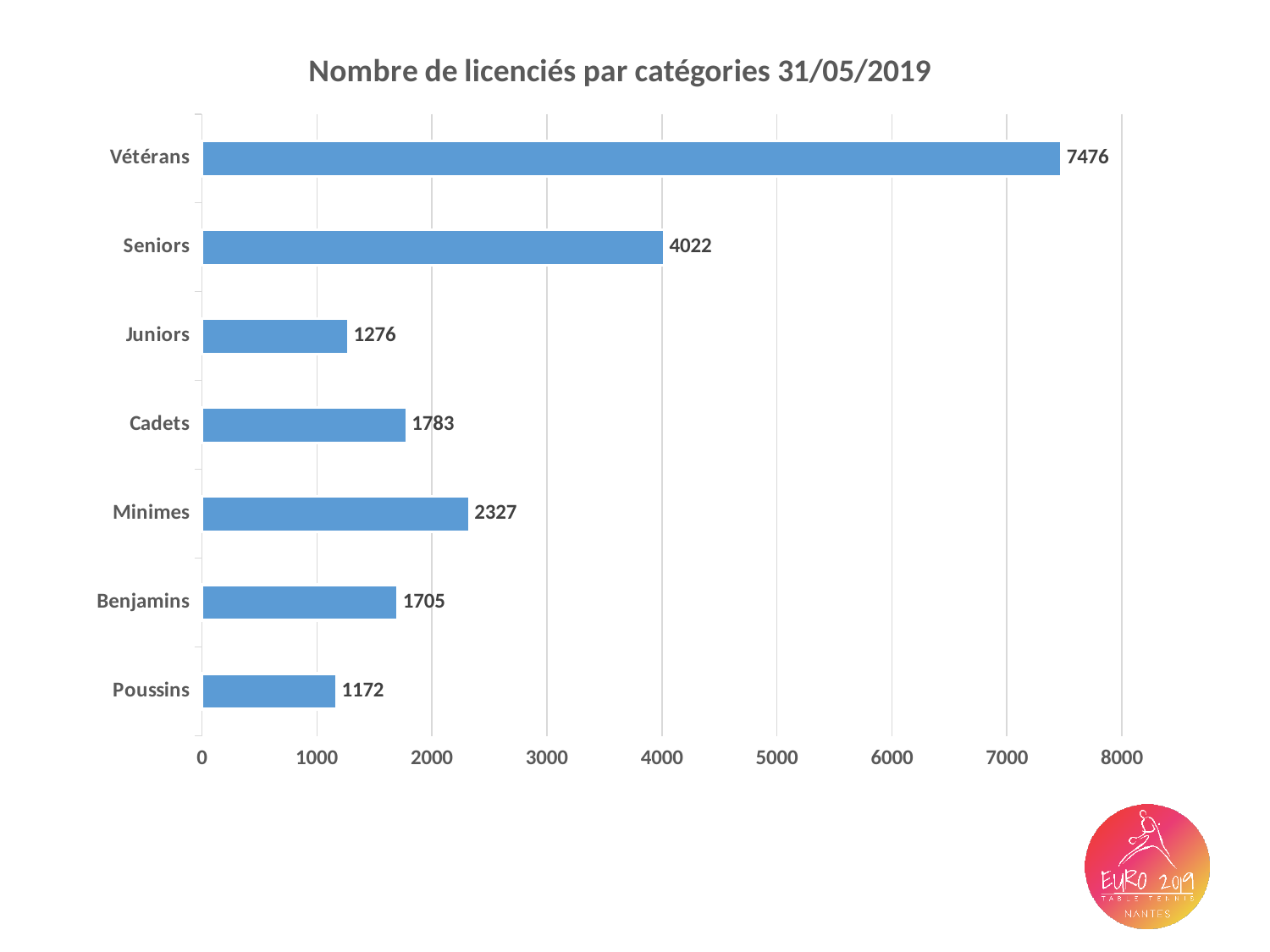
What kind of chart is this? Bar chart What is the value for Seniors? 4022 Which category has the highest value? Vétérans What is the difference between the values for Vétérans and Seniors? 3454 What is the title of the chart? Nombre de licenciés par catégories 31/05/2019 Which is larger, the value for Minimes or the value for Juniors? Minimes What is the value for Poussins? 1172 What is the difference between the values for Cadets and Benjamins? 78 What is the value for Vétérans? 7476 Which category has the lowest value? Poussins What is the value for Minimes? 2327 How many categories are shown in the chart? 7